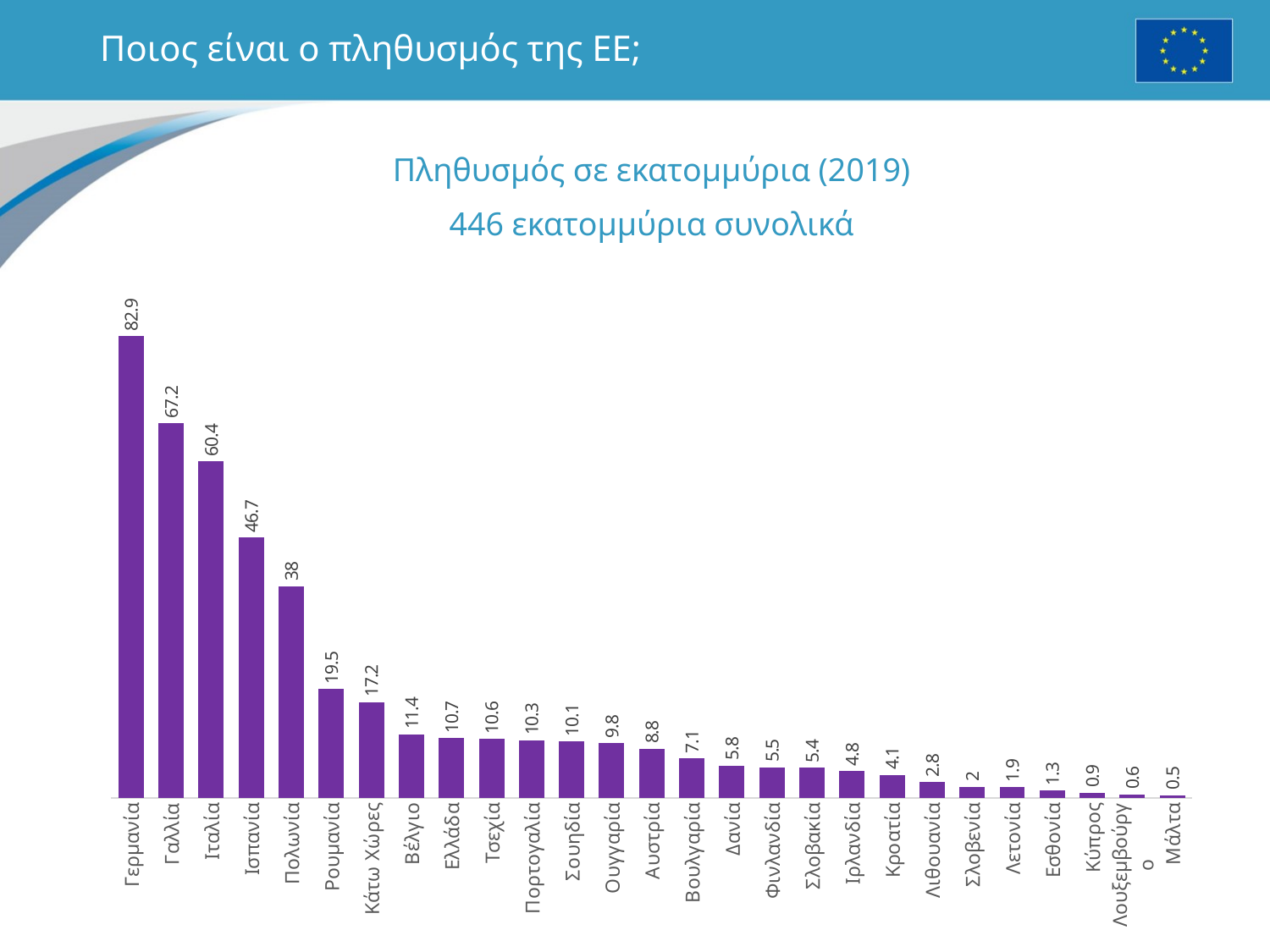
Do the values rise or fall from left to right along the x axis? Fall Which country has the highest population in the chart? Γερμανία Which has a larger value, Ρουμανία or Βέλγιο? Ρουμανία What is the difference between the values for Γαλλία and Ιταλία? 6.8 How many countries are shown in the chart? 27 What is the population value shown for Ελλάδα? 10.7 What is the population value shown for Γερμανία? 82.9 What is the difference between the values for Ισπανία and Πολωνία? 8.7 What kind of chart is shown on the slide? Bar chart What is the title of the chart? Πληθυσμός σε εκατομμύρια (2019) What is the population value shown for Κάτω Χώρες? 17.2 Which country has the lowest population in the chart? Μάλτα